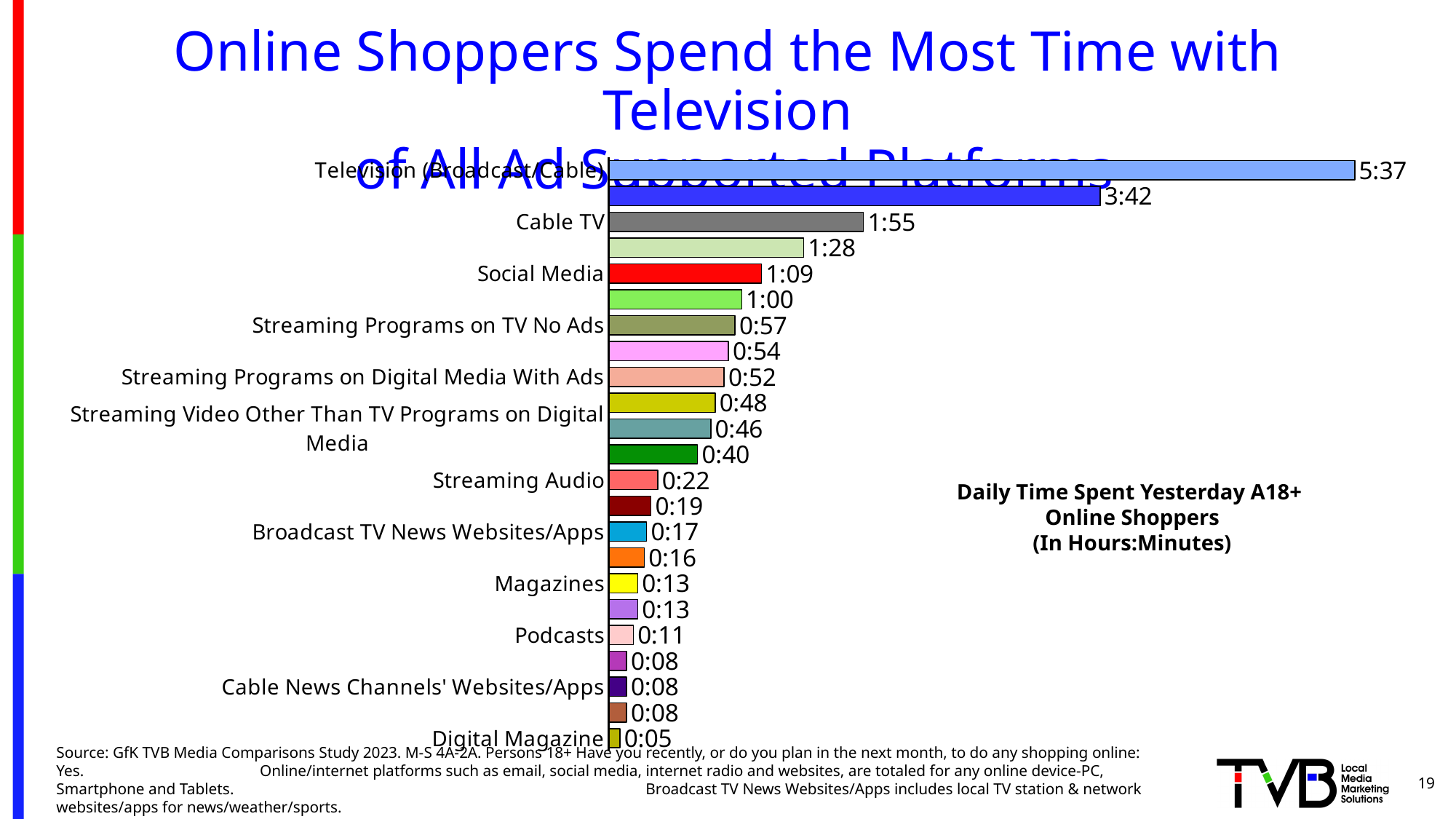
Which has a larger value, Streaming Audio or Broadcast TV News Websites/Apps? Streaming Audio What is the value shown for Social Media? 1:09 What is the daily time spent with Television (Broadcast/Cable) by online shoppers? 5:37 What is the value shown for Streaming Programs on TV No Ads? 0:57 What is the value shown for Streaming Audio? 0:22 Which platform has the lowest daily time spent? Digital Magazine How much more time is spent with Cable TV than with Social Media? 0:46 What is the value shown for Podcasts? 0:11 What is the value shown for Cable TV? 1:55 In what units are the values on the chart expressed, according to the chart's caption? Hours:Minutes Which platform has the highest daily time spent? Television (Broadcast/Cable) What kind of chart is shown on the slide? Bar chart